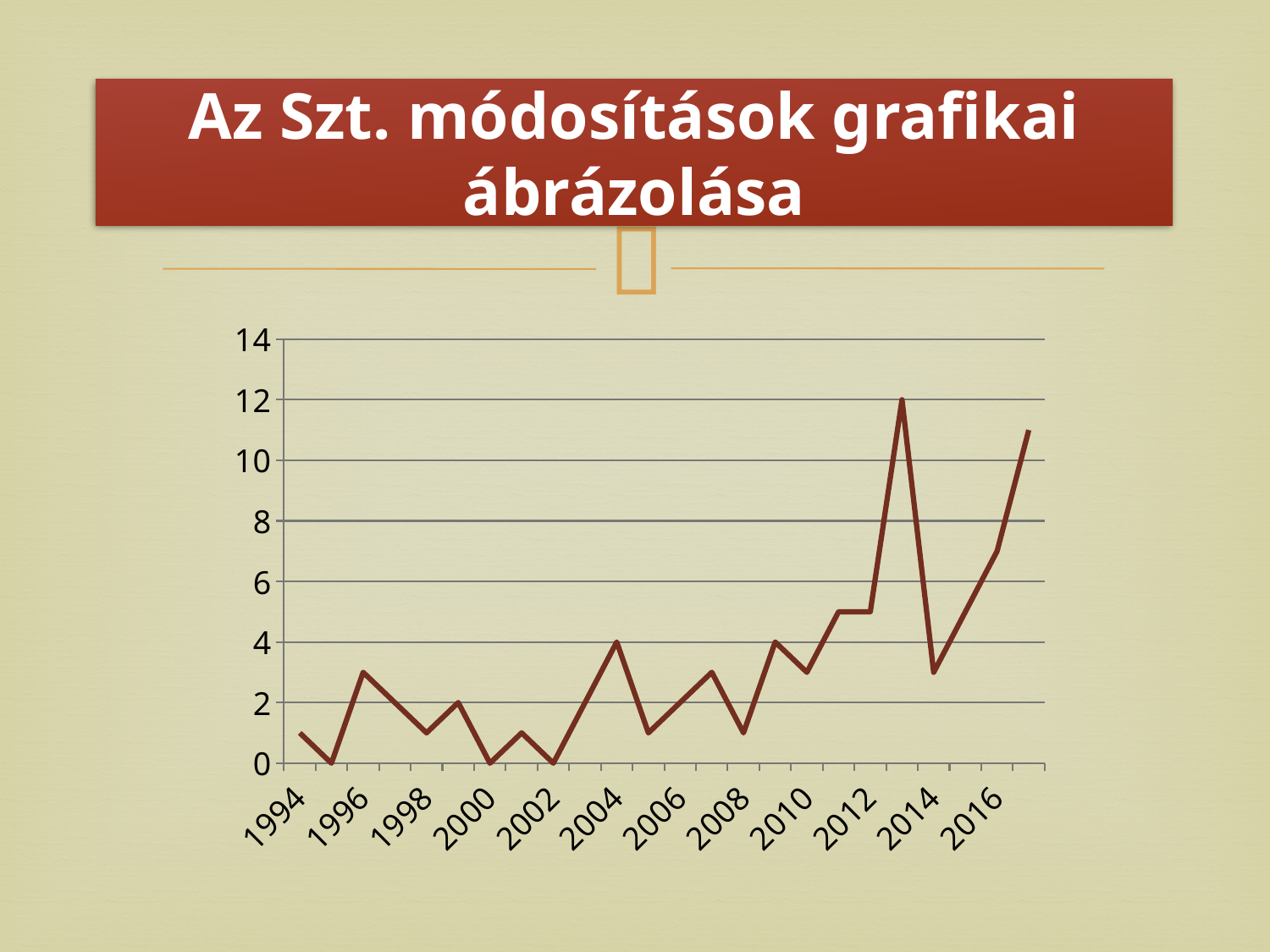
How many year labels are shown on the x axis? 12 What is the value for 2004? 4 Is the value for 1994 greater or less than 2? less What is the title of the slide containing the chart? Az Szt. módosítások grafikai ábrázolása In which year does the line reach its highest value? 2013 What is the highest value reached by the line? 12 Overall, do the values rise or fall from 1994 to the end of the series? rise Is the value for 2013 greater or less than 10? greater Which year has the larger value, 2004 or 2016? 2016 What kind of chart is shown on the slide? line chart